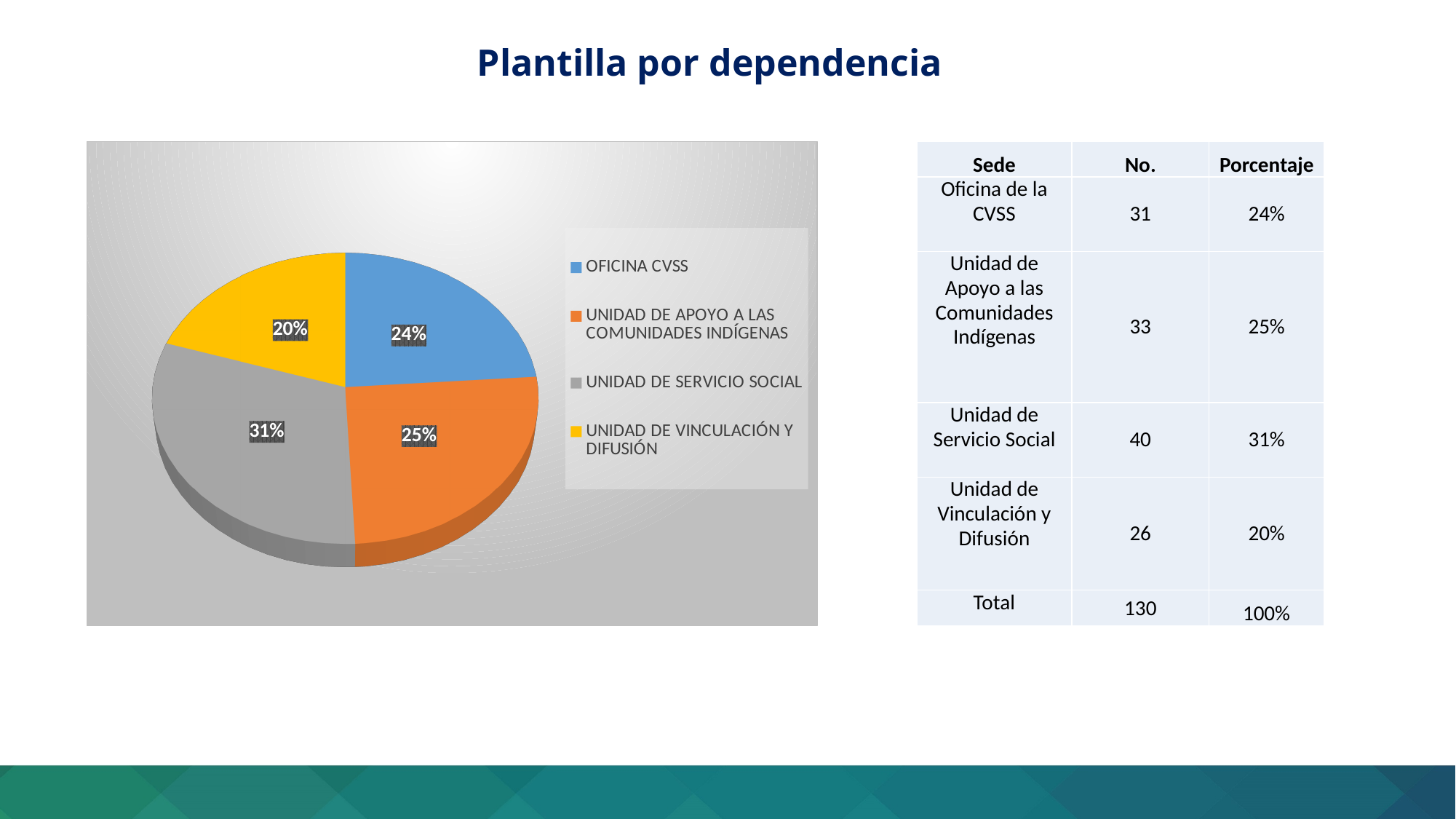
Which slice is larger in the pie chart: OFICINA CVSS or UNIDAD DE APOYO A LAS COMUNIDADES INDÍGENAS? UNIDAD DE APOYO A LAS COMUNIDADES INDÍGENAS What percentage does the pie chart show for UNIDAD DE SERVICIO SOCIAL? 31% What kind of chart is shown on the slide? Pie chart What percentage does the pie chart show for OFICINA CVSS? 24% What is the title of the slide containing the pie chart? Plantilla por dependencia How many slices does the pie chart have? 4 What percentage does the pie chart show for UNIDAD DE APOYO A LAS COMUNIDADES INDÍGENAS? 25% Which category has the largest slice in the pie chart? UNIDAD DE SERVICIO SOCIAL What colour is the UNIDAD DE SERVICIO SOCIAL slice in the pie chart? Grey What is the difference in percentage points between UNIDAD DE SERVICIO SOCIAL and UNIDAD DE VINCULACIÓN Y DIFUSIÓN in the pie chart? 11 What percentage does the pie chart show for UNIDAD DE VINCULACIÓN Y DIFUSIÓN? 20% Which category has the smallest slice in the pie chart? UNIDAD DE VINCULACIÓN Y DIFUSIÓN